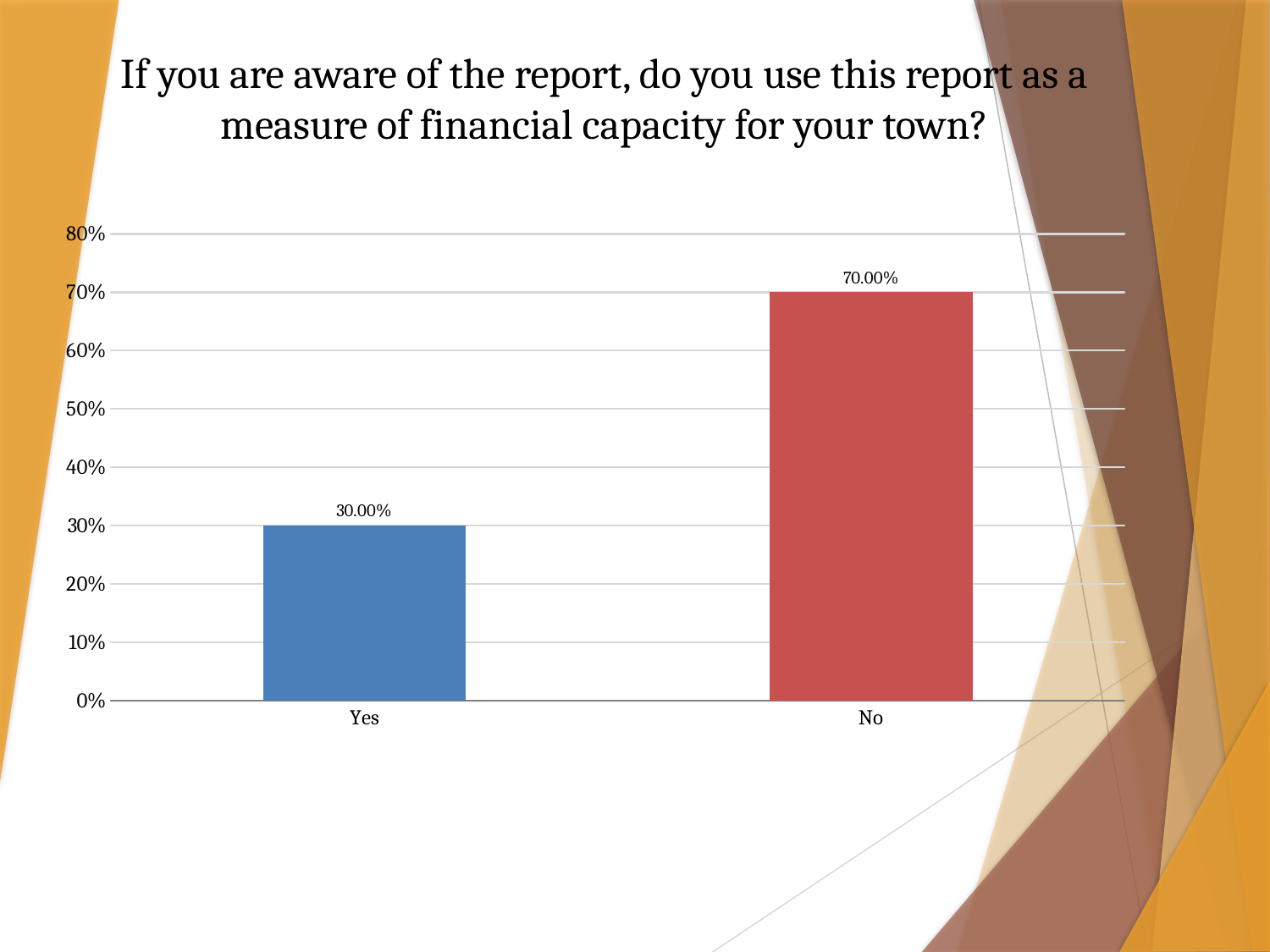
How many categories are shown on the x axis? 2 What is the title of the chart? If you are aware of the report, do you use this report as a measure of financial capacity for your town? What kind of chart is shown on the slide? bar chart Is the value for No greater or less than 50%? greater What is the difference between the values for No and Yes? 40.00% What is the value for No? 70.00% Which is larger, the value for Yes or the value for No? No Is the value for Yes greater or less than 40%? less What colour is the bar for No? red Which category has the highest value? No Which category has the lowest value? Yes What is the value for Yes? 30.00%